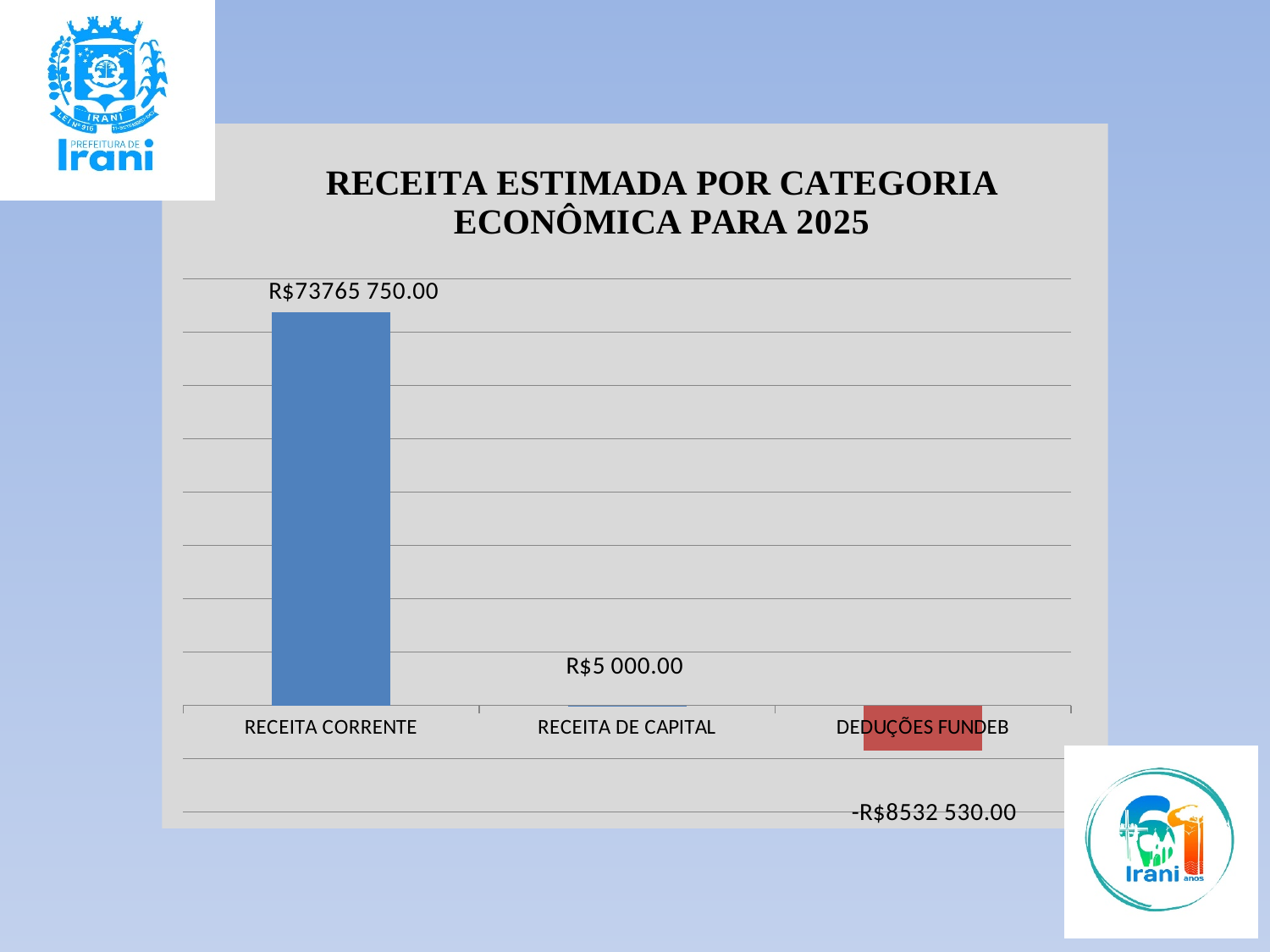
What is the difference between the values for RECEITA DE CAPITAL and DEDUÇÕES FUNDEB? R$8537 530.00 What kind of chart is shown on the slide? Bar chart How many categories are shown in the chart? 3 Which is larger, the value for RECEITA DE CAPITAL or the value for DEDUÇÕES FUNDEB? RECEITA DE CAPITAL Which category has the highest value? RECEITA CORRENTE What is the value for DEDUÇÕES FUNDEB? -R$8532 530.00 Which category is drawn with a red bar? DEDUÇÕES FUNDEB What is the difference between the values for RECEITA CORRENTE and RECEITA DE CAPITAL? R$73760 750.00 Which category has the lowest value? DEDUÇÕES FUNDEB What is the title of the chart? RECEITA ESTIMADA POR CATEGORIA ECONÔMICA PARA 2025 What is the value for RECEITA DE CAPITAL? R$5 000.00 What is the value for RECEITA CORRENTE? R$73765 750.00